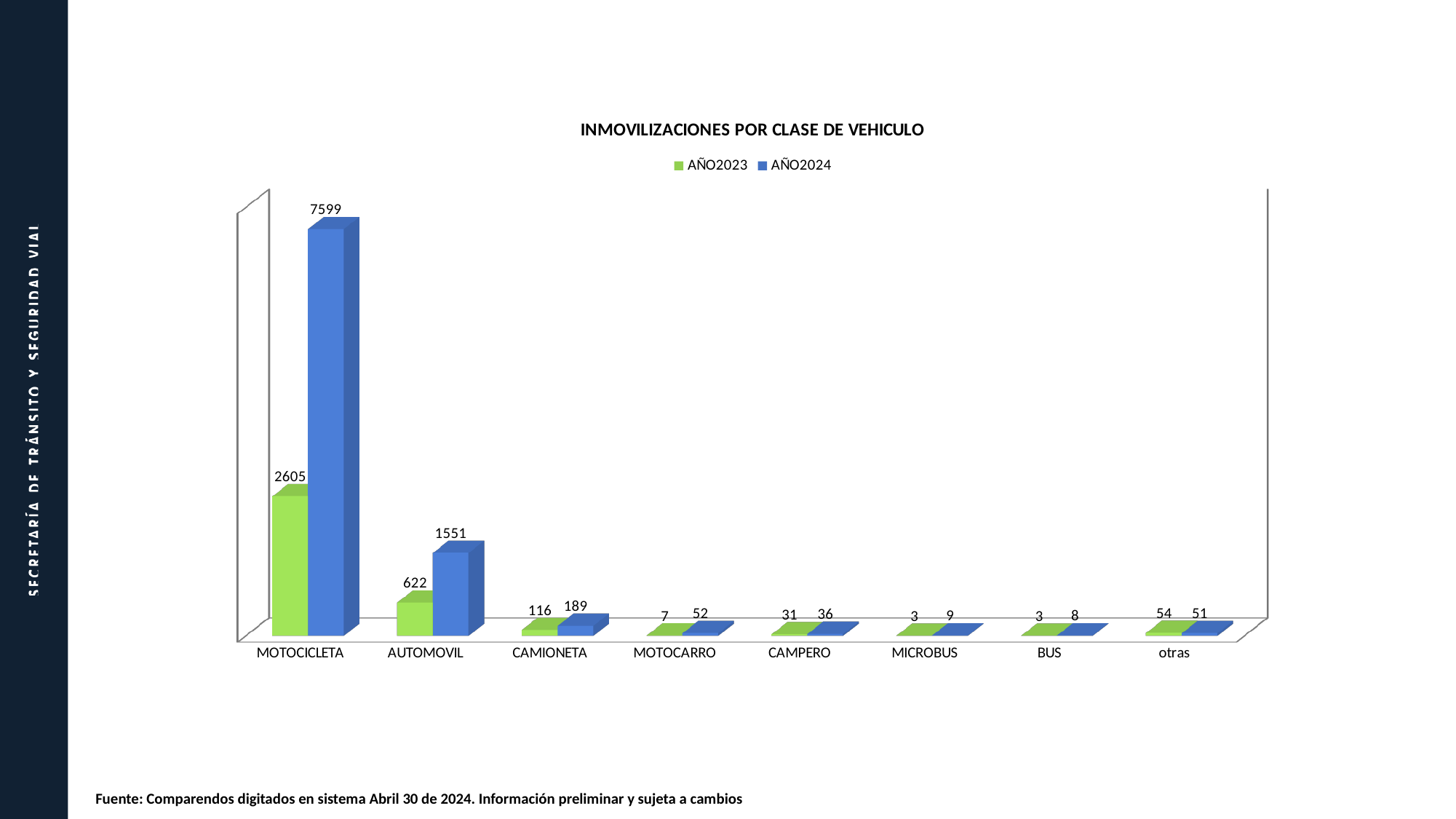
Which is larger for otras: the AÑO2023 value or the AÑO2024 value? AÑO2023 What is the value for MICROBUS in the AÑO2023 series? 3 How many vehicle categories are shown on the x axis? 8 What is the value for CAMIONETA in the AÑO2024 series? 189 What is the value for MOTOCICLETA in the AÑO2024 series? 7599 What kind of chart is shown on the slide? Bar chart Which category has the lowest value in the AÑO2024 series? BUS How many series does the legend list? 2 Which category has the highest value in the AÑO2024 series? MOTOCICLETA What is the value for AUTOMOVIL in the AÑO2023 series? 622 What is the title of the chart? INMOVILIZACIONES POR CLASE DE VEHICULO What is the difference between the AÑO2024 and AÑO2023 values for MOTOCICLETA? 4994